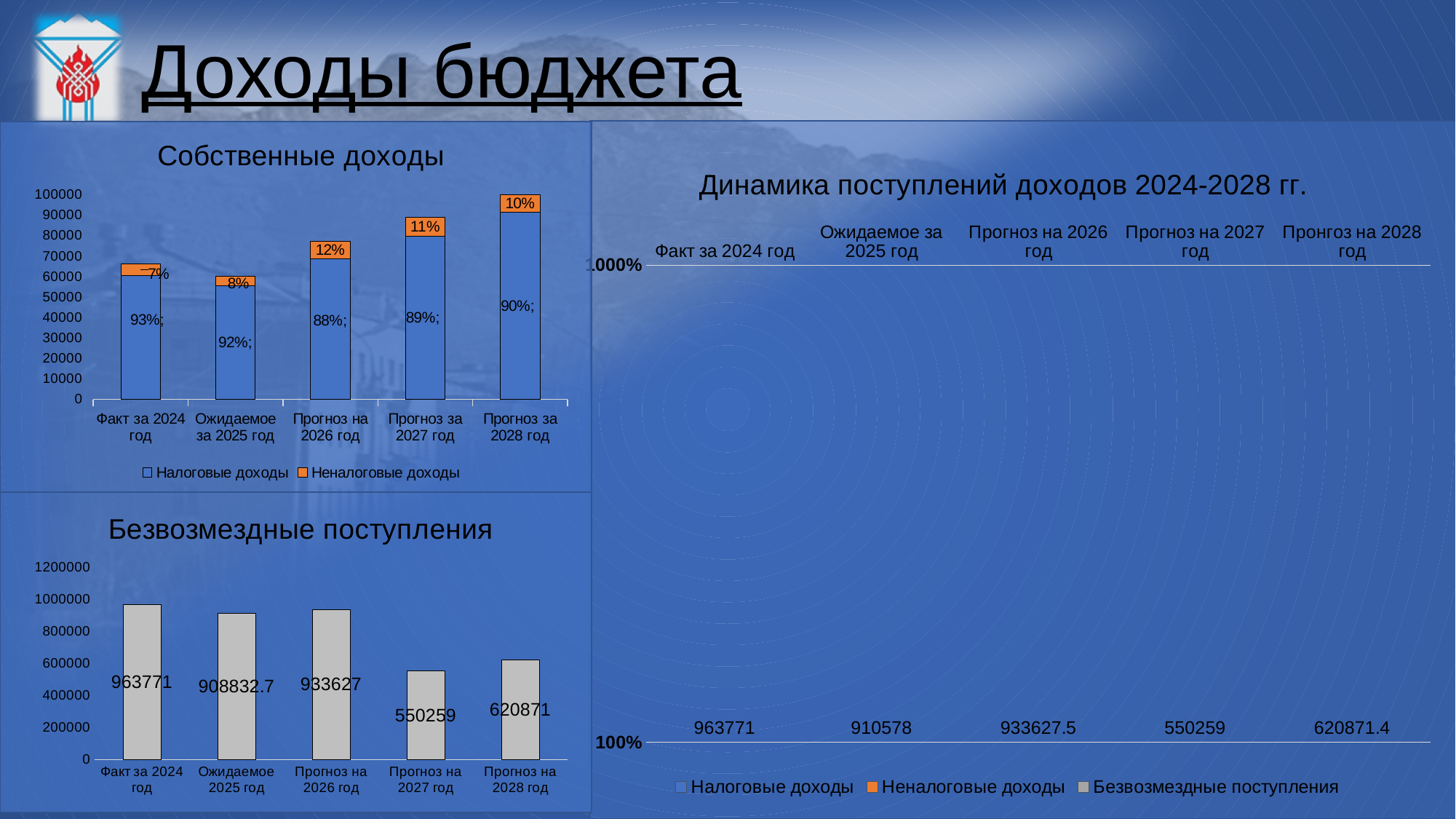
In the "Безвозмездные поступления" chart, which is larger: the value for Ожидаемое 2025 год or for Прогноз на 2026 год? Прогноз на 2026 год In the "Собственные доходы" chart, which category has the highest labelled share of Неналоговые доходы? Прогноз на 2026 год In the "Собственные доходы" chart, what share is labelled for Налоговые доходы in Факт за 2024 год? 93% In the "Безвозмездные поступления" chart, which category has the lowest value? Прогноз на 2027 год How many series does the legend of the "Собственные доходы" chart list? 2 In the "Безвозмездные поступления" chart, what is the value for Факт за 2024 год? 963771 In the "Безвозмездные поступления" chart, what is the difference between the values for Факт за 2024 год and Прогноз на 2027 год? 413512 In the "Собственные доходы" chart, what share is labelled for Неналоговые доходы in Прогноз на 2026 год? 12% How many categories are shown in the "Безвозмездные поступления" chart? 5 What kind of chart is "Собственные доходы"? bar chart In the "Собственные доходы" chart, is the total bar height for Прогноз за 2028 год greater or less than 90000? greater How many series does the legend of the "Динамика поступлений доходов 2024-2028 гг." chart list? 3